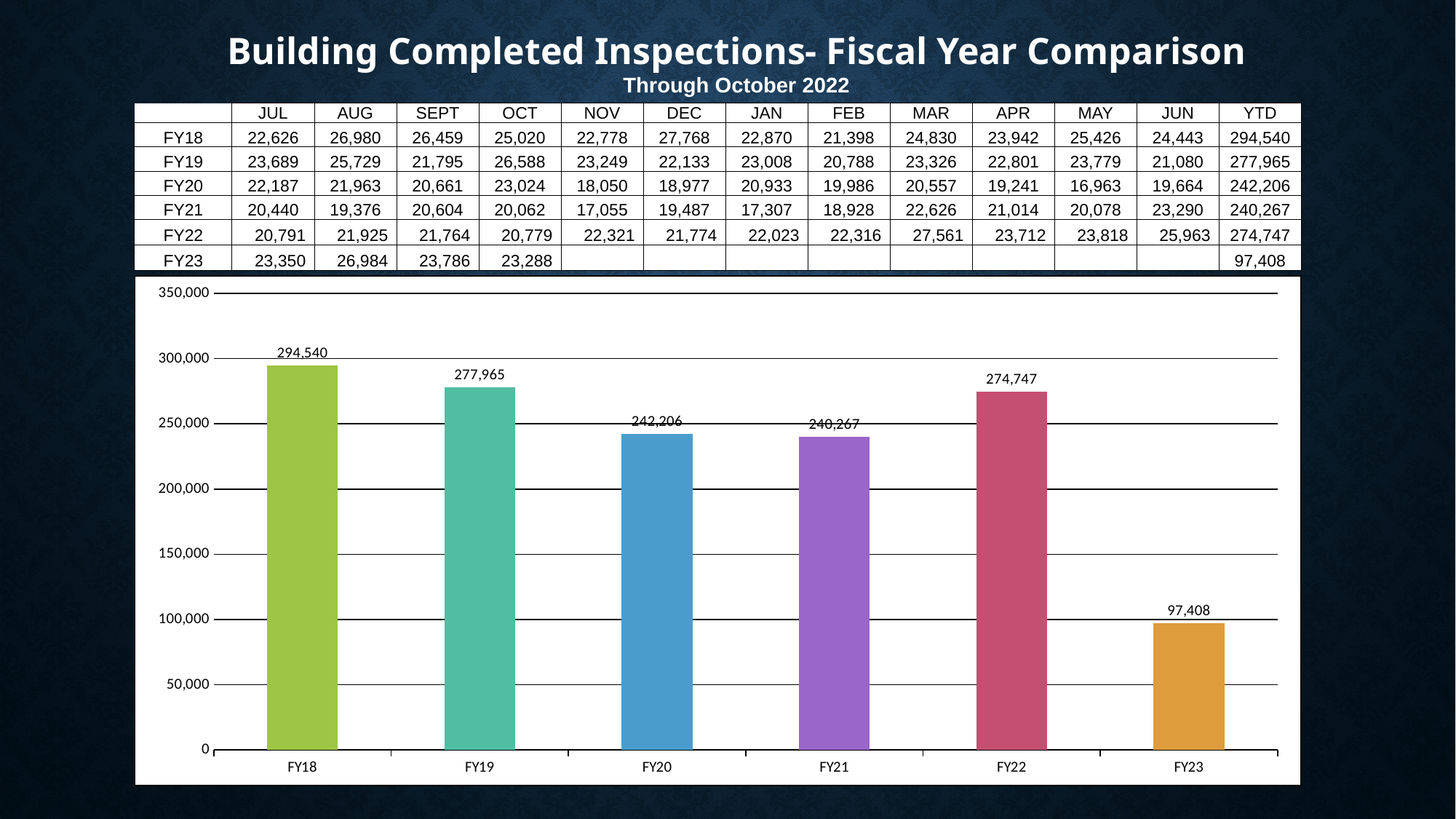
Which fiscal year has the lowest bar in the chart? FY23 What is the title of the slide containing the chart? Building Completed Inspections- Fiscal Year Comparison What is the difference between the FY18 and FY19 values in the bar chart? 16,575 What kind of chart is shown on the slide? bar chart Is the value for FY20 in the bar chart greater or less than 250,000? less What is the difference between the FY22 and FY23 values in the bar chart? 177,339 How many fiscal years are plotted as bars in the chart? 6 Which is larger in the bar chart, the value for FY18 or the value for FY22? FY18 What is the value shown for FY18 in the bar chart? 294,540 What is the value shown for FY23 in the bar chart? 97,408 Which fiscal year has the highest bar in the chart? FY18 What is the value shown for FY21 in the bar chart? 240,267